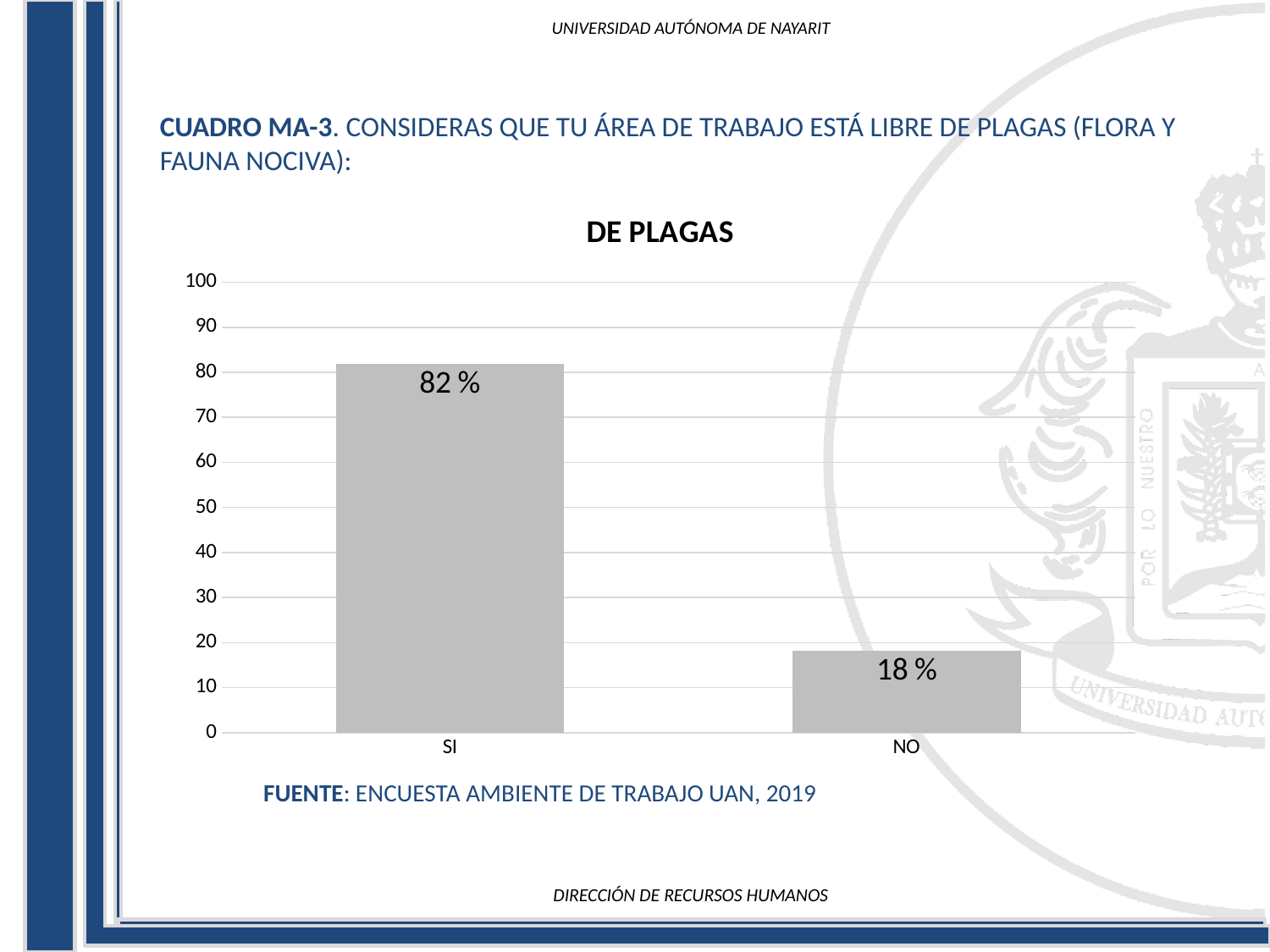
What is the value for NO? 18 % What is the highest value shown on the y axis? 100 What kind of chart is shown? bar chart Is the value for NO greater or less than 20? less Which category has the lowest value? NO Which category has the highest value? SI What is the value for SI? 82 % What is the title of the chart? DE PLAGAS Which is larger, the value for SI or the value for NO? SI What is the difference between the values for SI and NO? 64 % Is the value for SI greater or less than 50? greater How many categories are shown on the x axis? 2